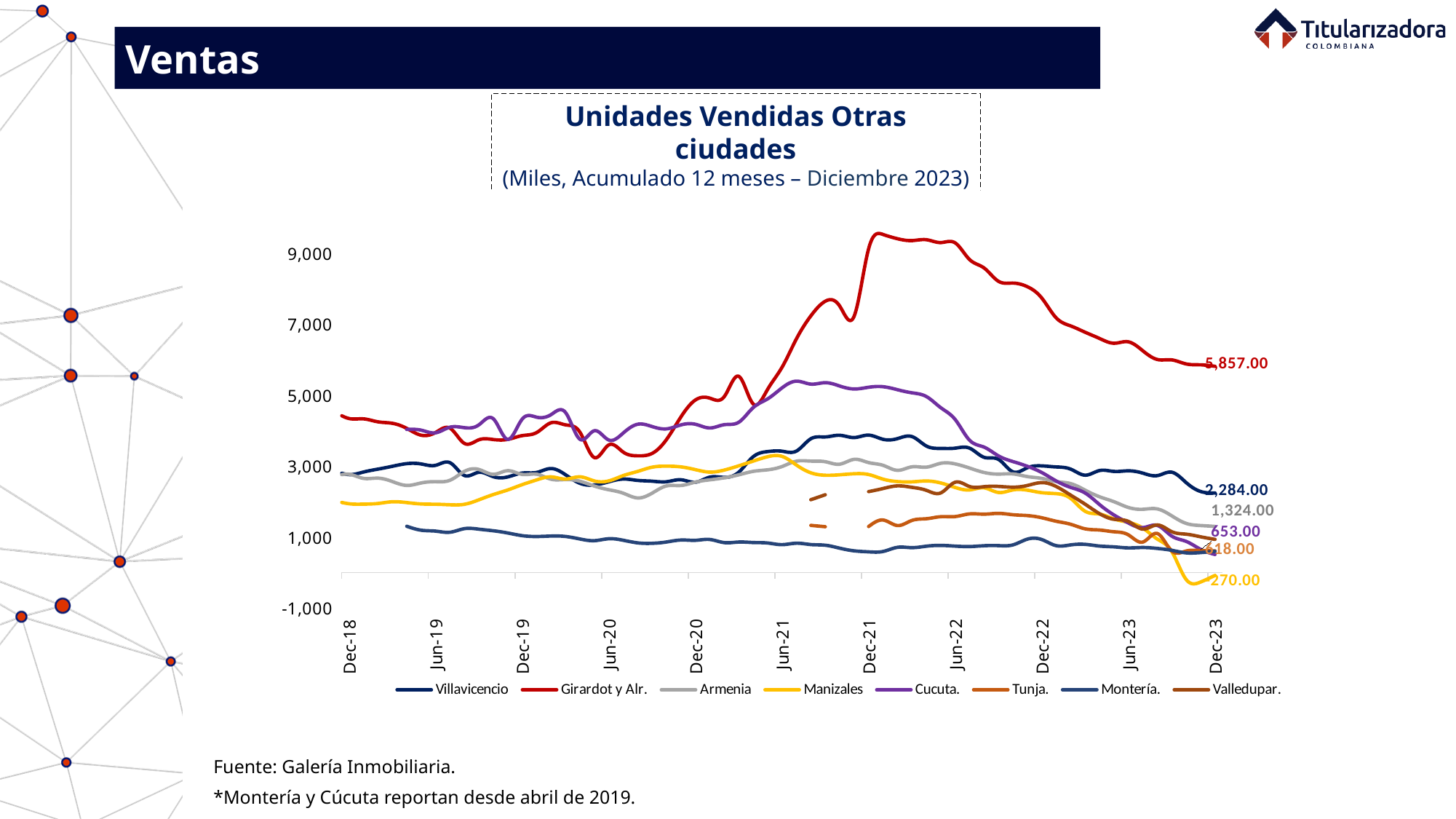
What is the title of the chart? Unidades Vendidas Otras ciudades What is the value labelled for Armenia at Dec-23? 1,324.00 How many series does the legend list? 8 At Dec-23, which is larger: the value for Armenia or the value for Cucuta? Armenia What is the value labelled for Villavicencio at Dec-23? 2,284.00 Is the peak value of the Girardot y Alr. line greater or less than 9,000? greater What is the value labelled for Manizales at Dec-23? 270.00 What is the value labelled for Girardot y Alr. at Dec-23? 5,857.00 Does the Girardot y Alr. line rise or fall between Dec-21 and Dec-23? fall What type of chart is shown on the slide? line chart Which series has the highest value at Dec-23? Girardot y Alr. What is the difference between the Dec-23 values of Girardot y Alr. and Villavicencio? 3,573.00